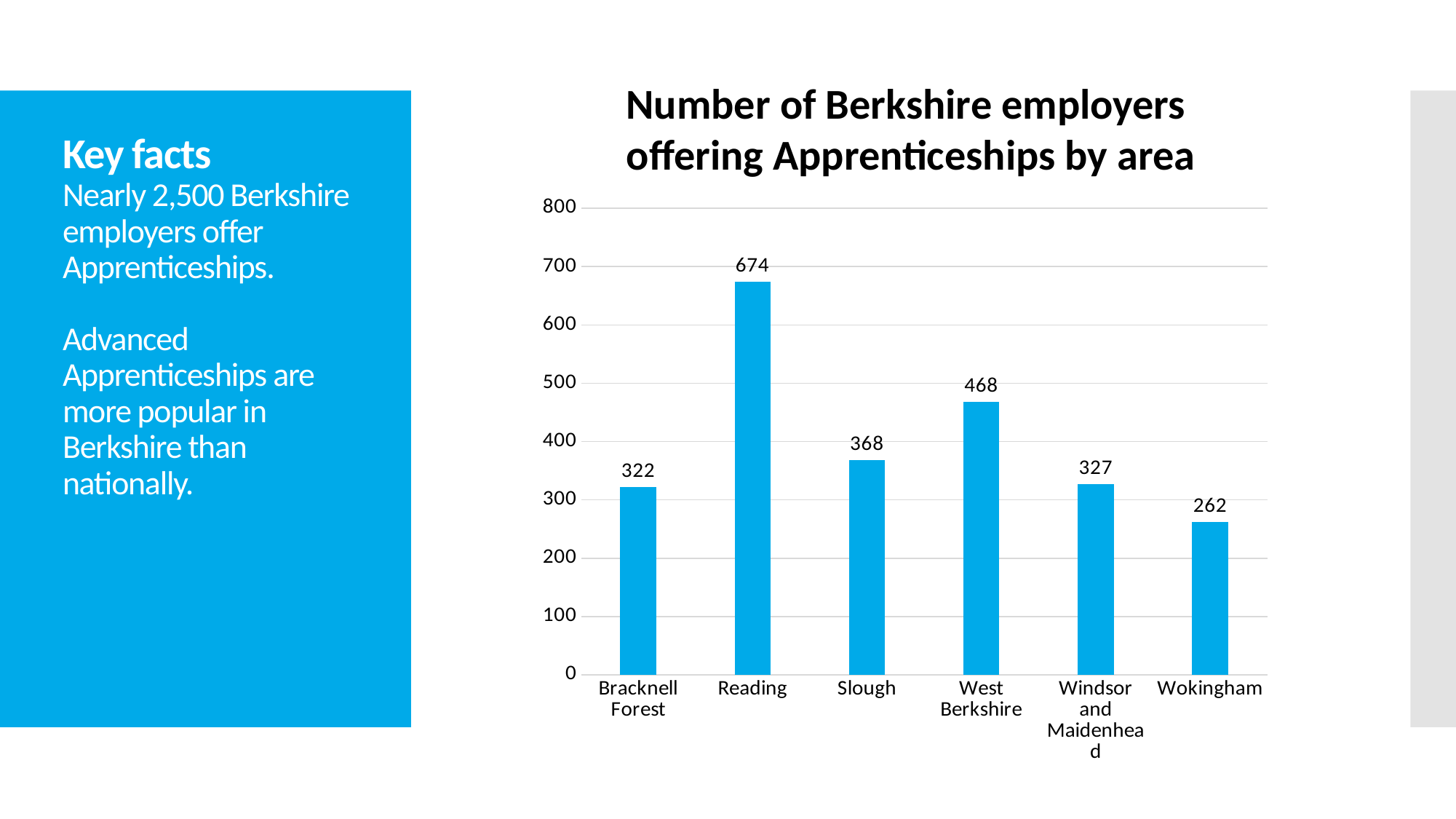
What is the value shown for Windsor and Maidenhead? 327 What is the title of the chart? Number of Berkshire employers offering Apprenticeships by area What is the difference between the values for Bracknell Forest and Wokingham? 60 How many Berkshire employers in Reading offer Apprenticeships according to the chart? 674 What is the difference between the values for Reading and West Berkshire? 206 Which is larger, the value for Slough or the value for Windsor and Maidenhead? Slough Which area has the lowest number of employers offering Apprenticeships? Wokingham What is the value shown for Slough? 368 Which area has the highest number of employers offering Apprenticeships? Reading Is the value for West Berkshire greater or less than 500? less How many areas are shown on the chart? 6 What kind of chart is shown on the slide? bar chart